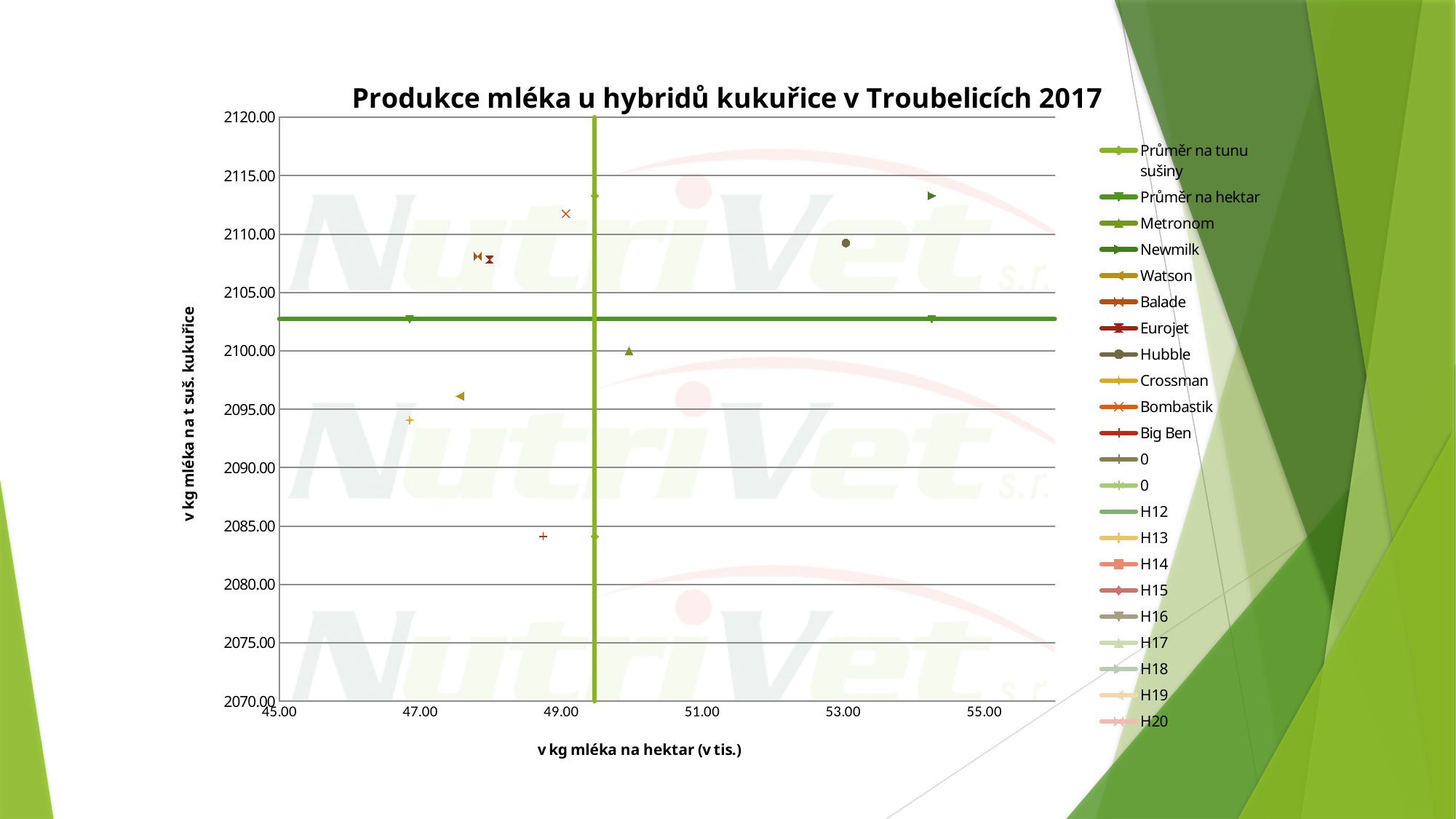
Which hybrid lies furthest to the right on the horizontal axis (v kg mléka na hektar)? Newmilk What is the label of the horizontal axis? v kg mléka na hektar (v tis.) Is the vertical-axis value for Watson greater or less than 2100.00? less Is the vertical-axis value for Hubble greater or less than 2105.00? greater What kind of chart is shown on the slide? scatter chart Is the horizontal-axis value for Newmilk greater or less than 53.00? greater How many entries does the legend list? 22 Which hybrid has the highest value on the vertical axis (v kg mléka na t suš. kukuřice)? Newmilk Which has the higher vertical-axis value, Hubble or Big Ben? Hubble What is the title of the chart? Produkce mléka u hybridů kukuřice v Troubelicích 2017 Which hybrid has the lowest value on the vertical axis (v kg mléka na t suš. kukuřice)? Big Ben